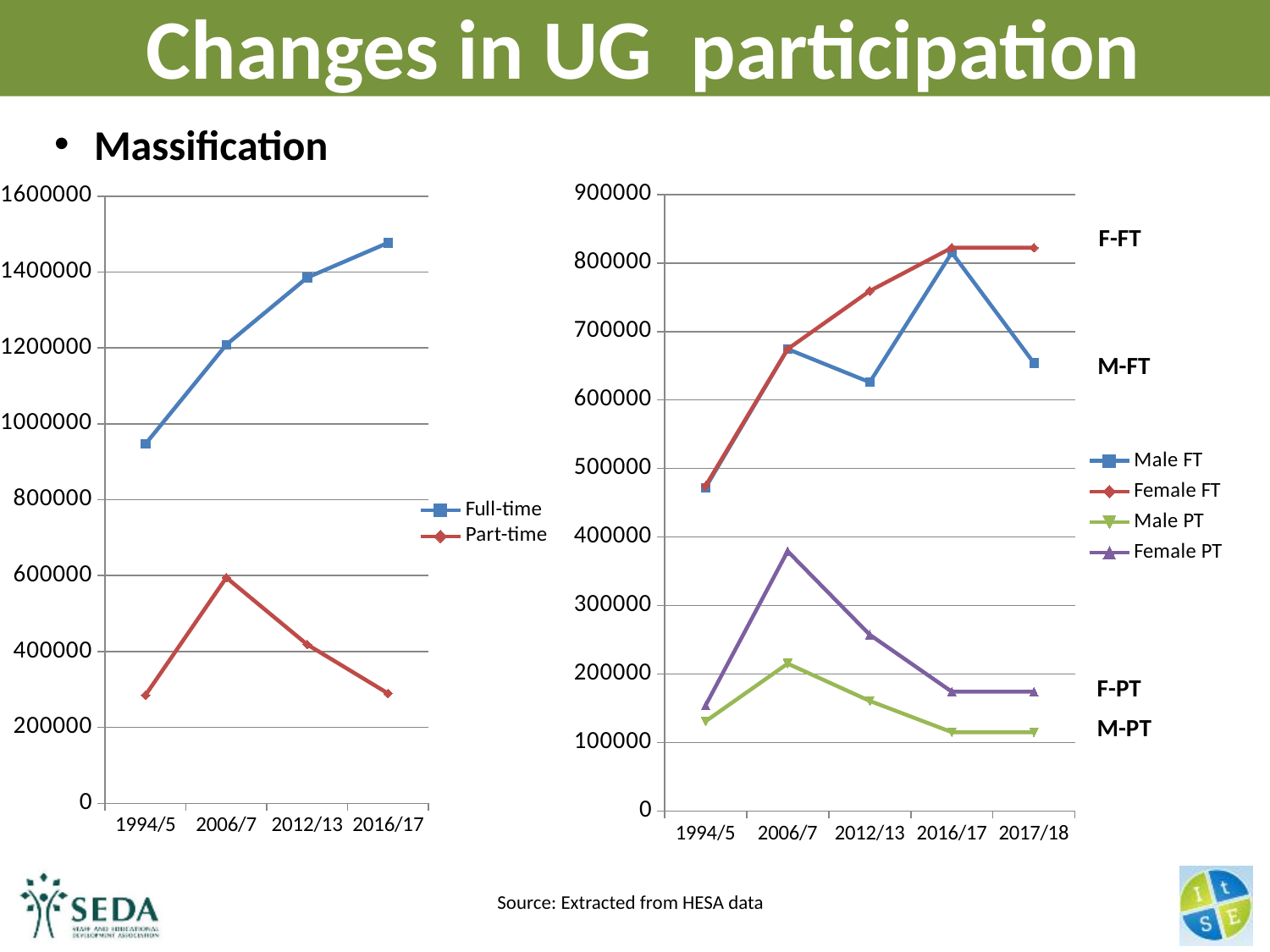
In the left chart, is the Part-time value for 2016/17 greater or less than 400000? less In the left chart, does the Full-time series rise or fall across the years shown? rise How many categories are shown on the x axis of the right chart? 5 What kind of chart is the left chart on the slide? line chart In the right chart, which is larger in 2017/18, Female FT or Male FT? Female FT In the right chart, is the Female FT value for 2017/18 greater or less than 800000? greater In the left chart, is the Full-time value for 2016/17 greater or less than 1400000? greater In the left chart, in which year is the Part-time value highest? 2006/7 How many series does the legend of the right chart list? 4 How many series does the legend of the left chart list? 2 In the right chart, in which year is the Male PT value highest? 2006/7